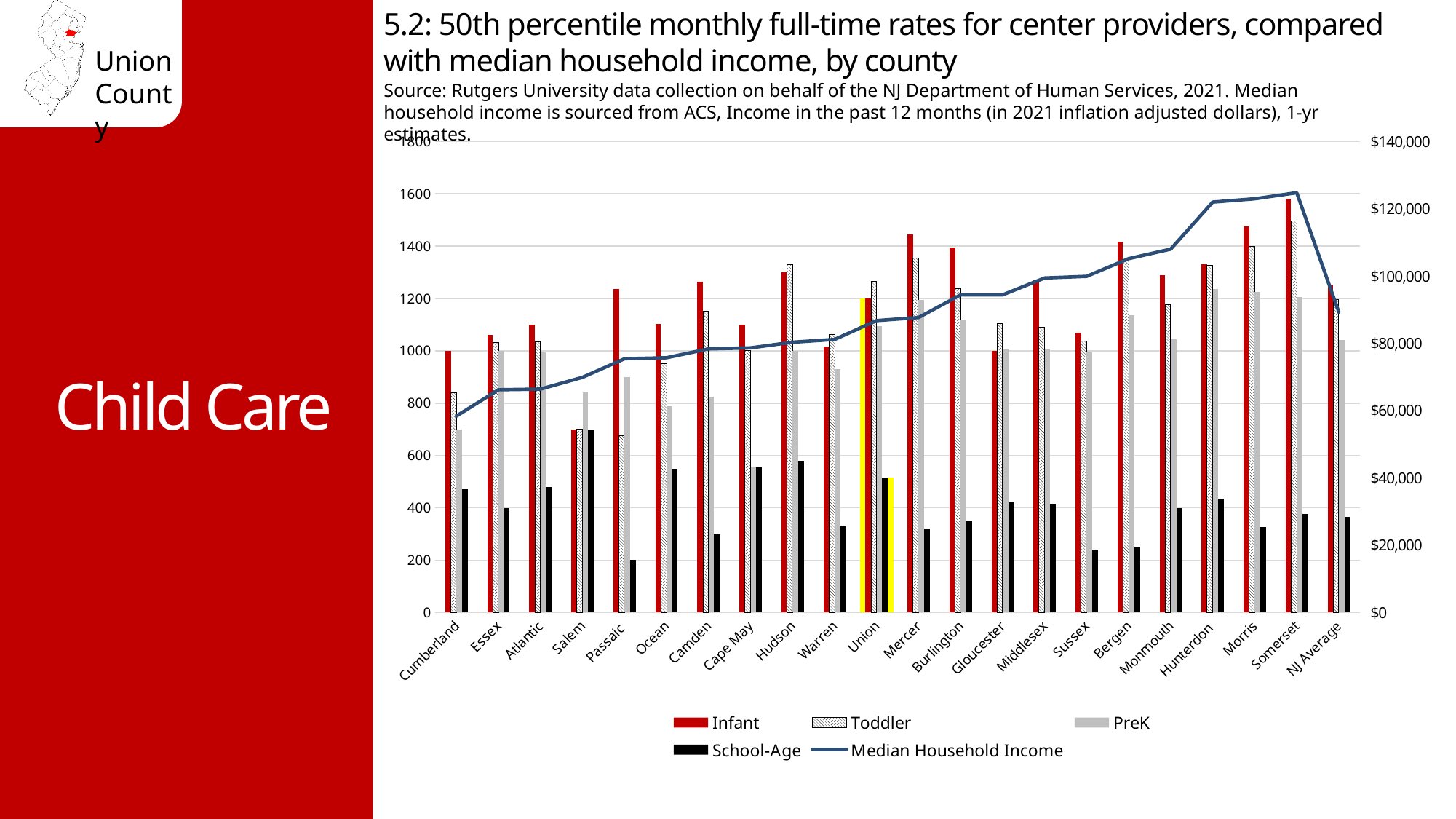
Which is larger, the Toddler rate for Hudson or the Toddler rate for Cumberland? Hudson How many series does the legend list? 5 How many categories are shown along the x axis? 22 Which category has the highest School-Age rate? Salem Which category has the lowest School-Age rate? Passaic Is the Infant rate for Somerset greater or less than 1400? greater Is the Median Household Income for Cumberland greater or less than $80,000? less Which category has the highest Infant rate? Somerset Which category has the lowest Median Household Income? Cumberland Which category has the lowest Infant rate? Salem Moving from Cumberland to Somerset along the x axis, does the Median Household Income line generally rise or fall? rise What kind of chart is shown on the slide? bar chart with a line series